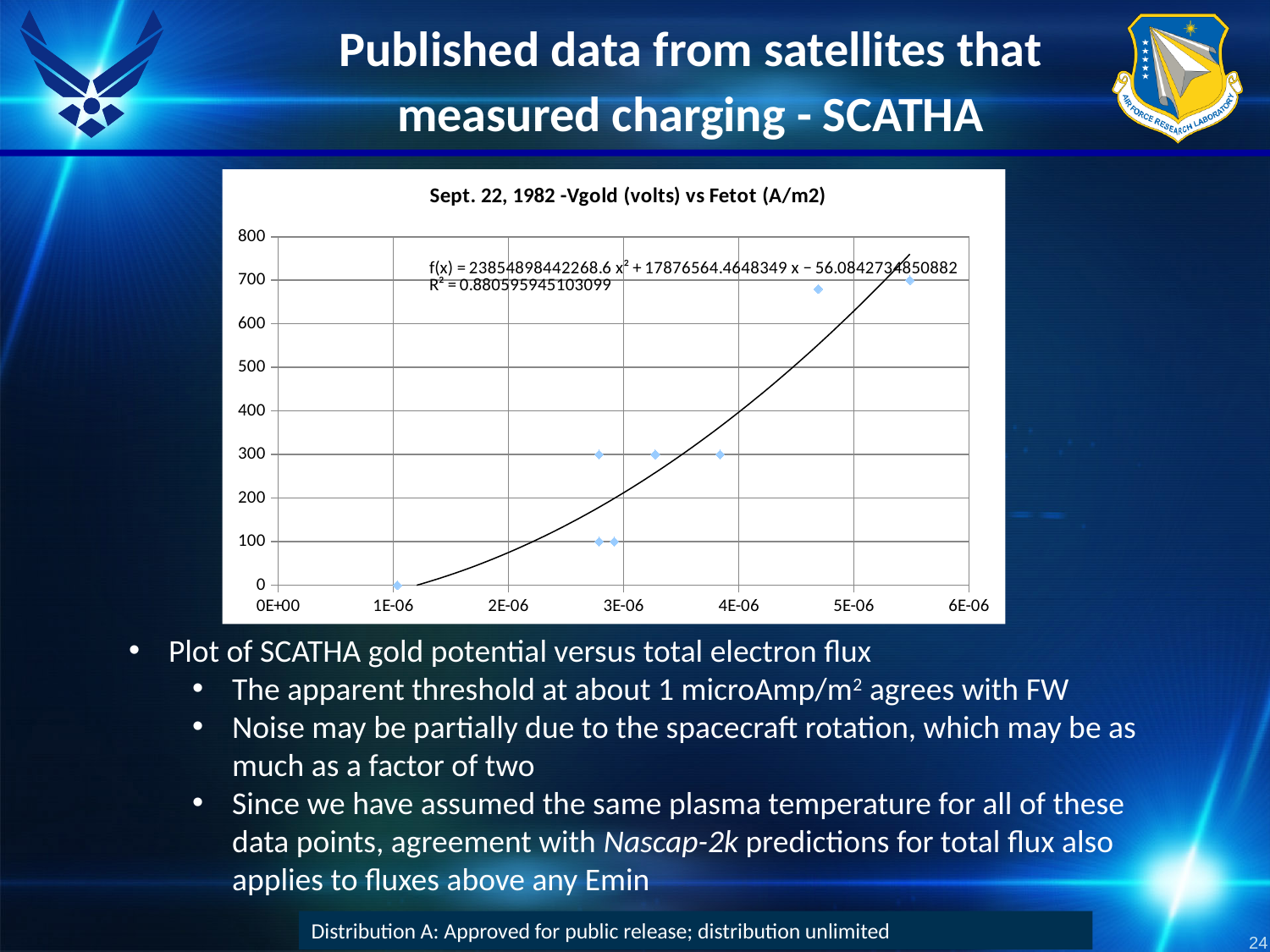
What is the highest value shown on the y axis? 800 What is the title of the chart? Sept. 22, 1982 -Vgold (volts) vs Fetot (A/m2) Which data point has the lowest y value on the chart? The point at x = 1E-06 How many data points are plotted on the chart? 8 Do the plotted values generally rise or fall as the x value increases? Rise Is the y value of the data point near x = 4.7E-06 greater or less than 500? greater What R² value is printed on the chart? R² = 0.880595945103099 Which has the larger y value: the data point near x = 4.7E-06 or the data point near x = 3.3E-06? The point near x = 4.7E-06 Is the y value of the data point near x = 3.8E-06 greater or less than 400? less What kind of chart is shown on the slide? Scatter chart Is the y value of the rightmost data point (near 5.5E-06) greater or less than 600? greater What is the y value of the data point located at x = 1E-06? 0